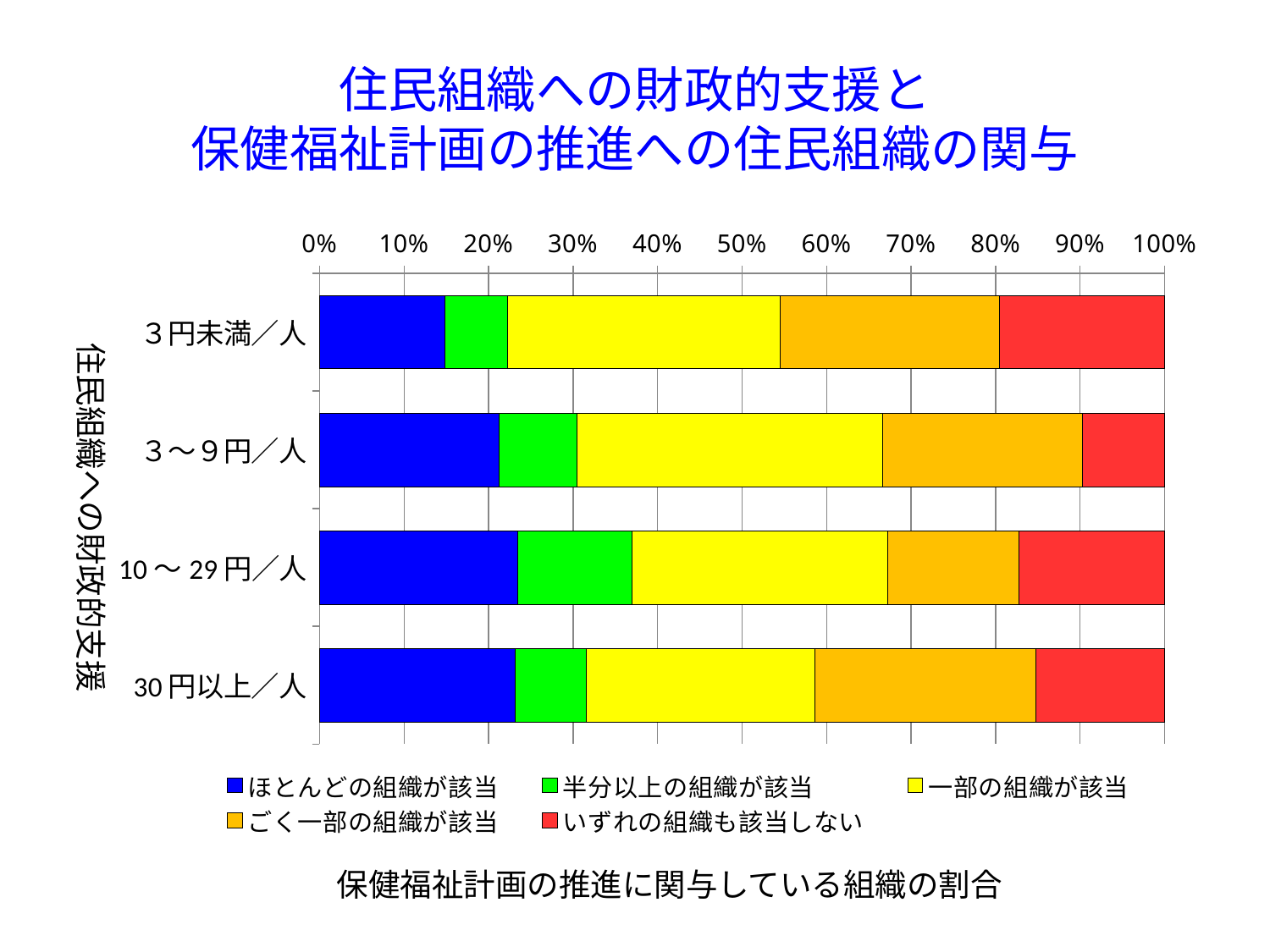
Which is larger: the ほとんどの組織が該当 segment for 3円未満／人 or for 10～29円／人? 10～29円／人 What is the label of the horizontal axis below the legend? 保健福祉計画の推進に関与している組織の割合 Which is larger: the いずれの組織も該当しない segment for 3円未満／人 or for 3～9円／人? 3円未満／人 Which category has the smallest ほとんどの組織が該当 segment? 3円未満／人 Is the value of ほとんどの組織が該当 for 3円未満／人 greater or less than 20%? less Which category has the smallest いずれの組織も該当しない segment? 3～9円／人 What kind of chart is shown on the slide? Stacked bar chart Is the value of ほとんどの組織が該当 for 10～29円／人 greater or less than 20%? greater How many categories (financial support levels) are shown on the vertical axis? 4 Is the value of いずれの組織も該当しない for 3～9円／人 greater or less than 20%? less How many series does the legend list? 5 Which category has the largest 半分以上の組織が該当 segment? 10～29円／人